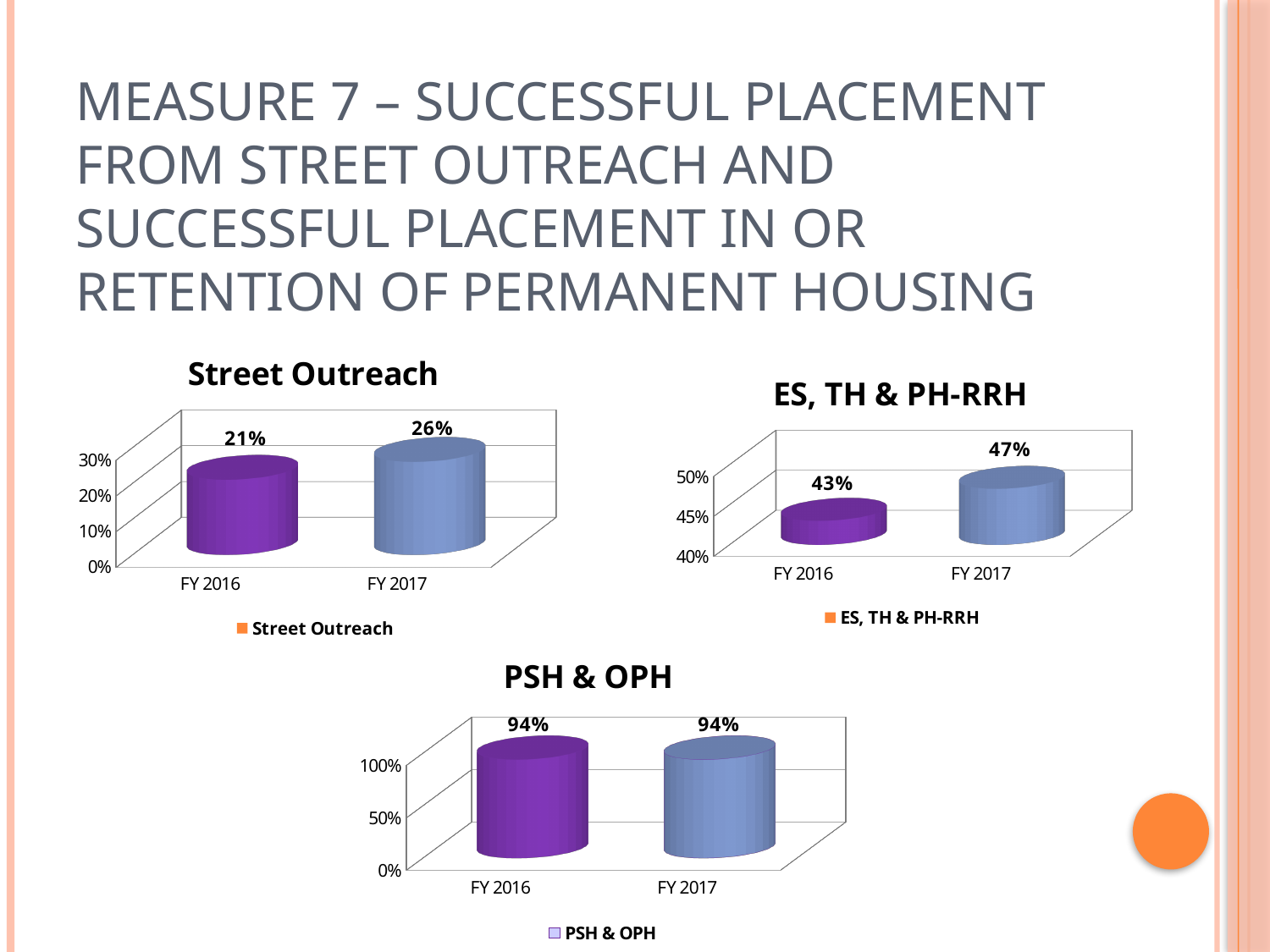
In the ES, TH & PH-RRH chart, what is the value for FY 2017? 47% What kind of chart is the ES, TH & PH-RRH chart? bar chart In the Street Outreach chart, do the values rise or fall from FY 2016 to FY 2017? rise In the Street Outreach chart, what is the value for FY 2017? 26% In the ES, TH & PH-RRH chart, what is the value for FY 2016? 43% In the ES, TH & PH-RRH chart, what is the difference between the FY 2017 and FY 2016 values? 4% In the Street Outreach chart, what is the difference between the FY 2017 and FY 2016 values? 5% In the ES, TH & PH-RRH chart, which fiscal year has the higher value? FY 2017 In the Street Outreach chart, which fiscal year has the lower value? FY 2016 How many categories are shown on the x axis of the PSH & OPH chart? 2 In the Street Outreach chart, what is the value for FY 2016? 21% In the PSH & OPH chart, what is the value for FY 2016? 94%